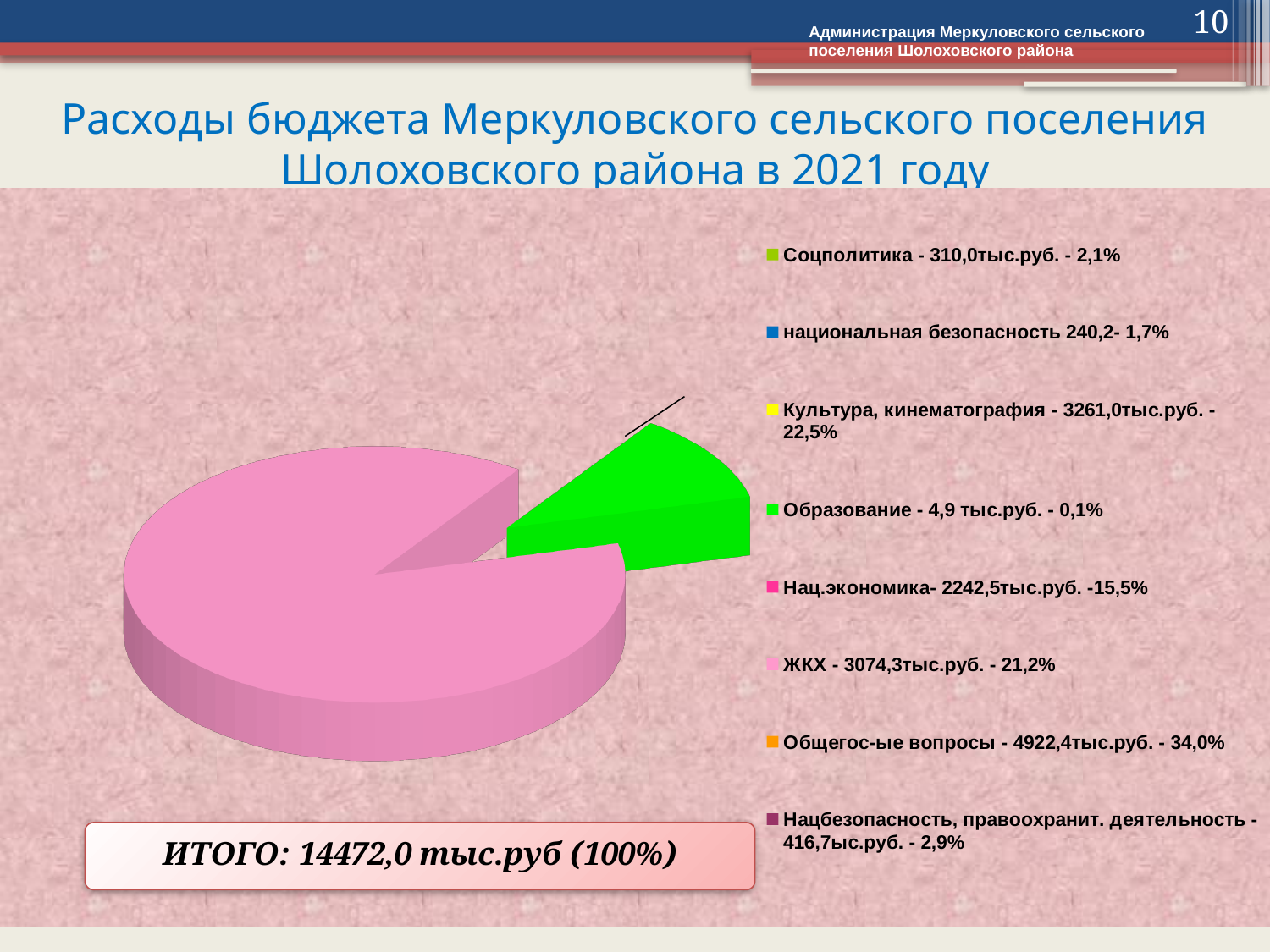
What is the total (ИТОГО) of the budget expenses shown on the slide? 14472,0 тыс.руб What is the difference in percentage share between Культура, кинематография and ЖКХ? 1,3% What share of the budget expenses does ЖКХ account for? 21,2% What is the value for Общегос-ые вопросы? 4922,4тыс.руб. What percentage share does Образование have? 0,1% Which category has the largest share of expenses? Общегос-ые вопросы What is the value for Культура, кинематография? 3261,0тыс.руб. What kind of chart is shown on the slide? pie chart Which is larger, the value for Нац.экономика or the value for ЖКХ? ЖКХ Which category has the smallest share of expenses? Образование How many categories does the legend of the pie chart list? 8 What is the value for Соцполитика? 310,0тыс.руб.